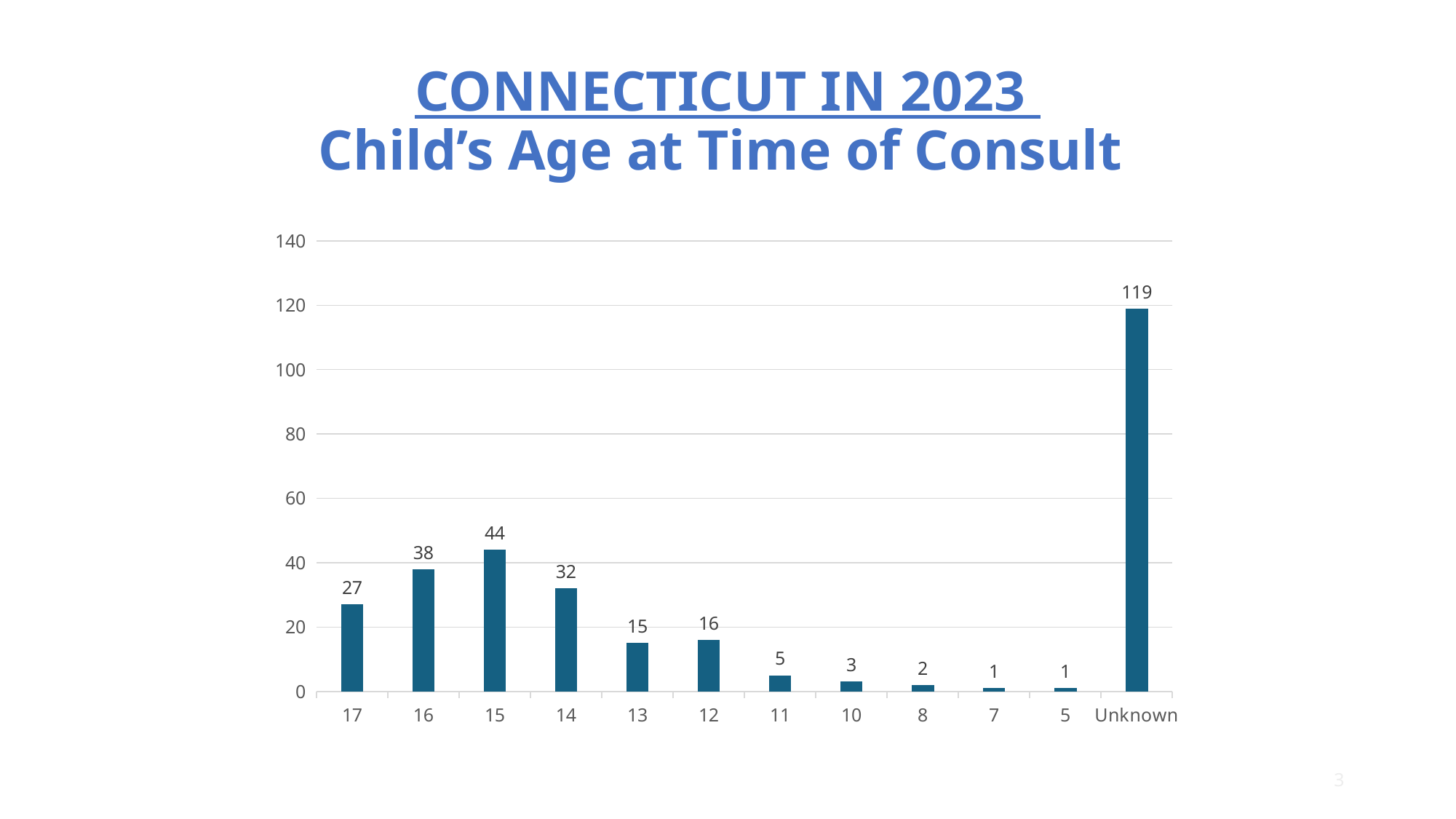
Which category has the highest value? Unknown What is the difference between the values for age 16 and age 14? 6 What kind of chart is shown on the slide? Bar chart What is the total of the values for ages 7 and 5? 2 Which is larger, the value for age 17 or the value for age 13? 17 What is the value for the Unknown category? 119 What is the value for age 12? 16 Which age category (excluding Unknown) has the highest value? 15 Is the value for Unknown greater or less than 100? greater What is the title of the chart on the slide? Connecticut in 2023 Child's Age at Time of Consult How many categories are shown on the x axis? 12 What is the value for age 15? 44